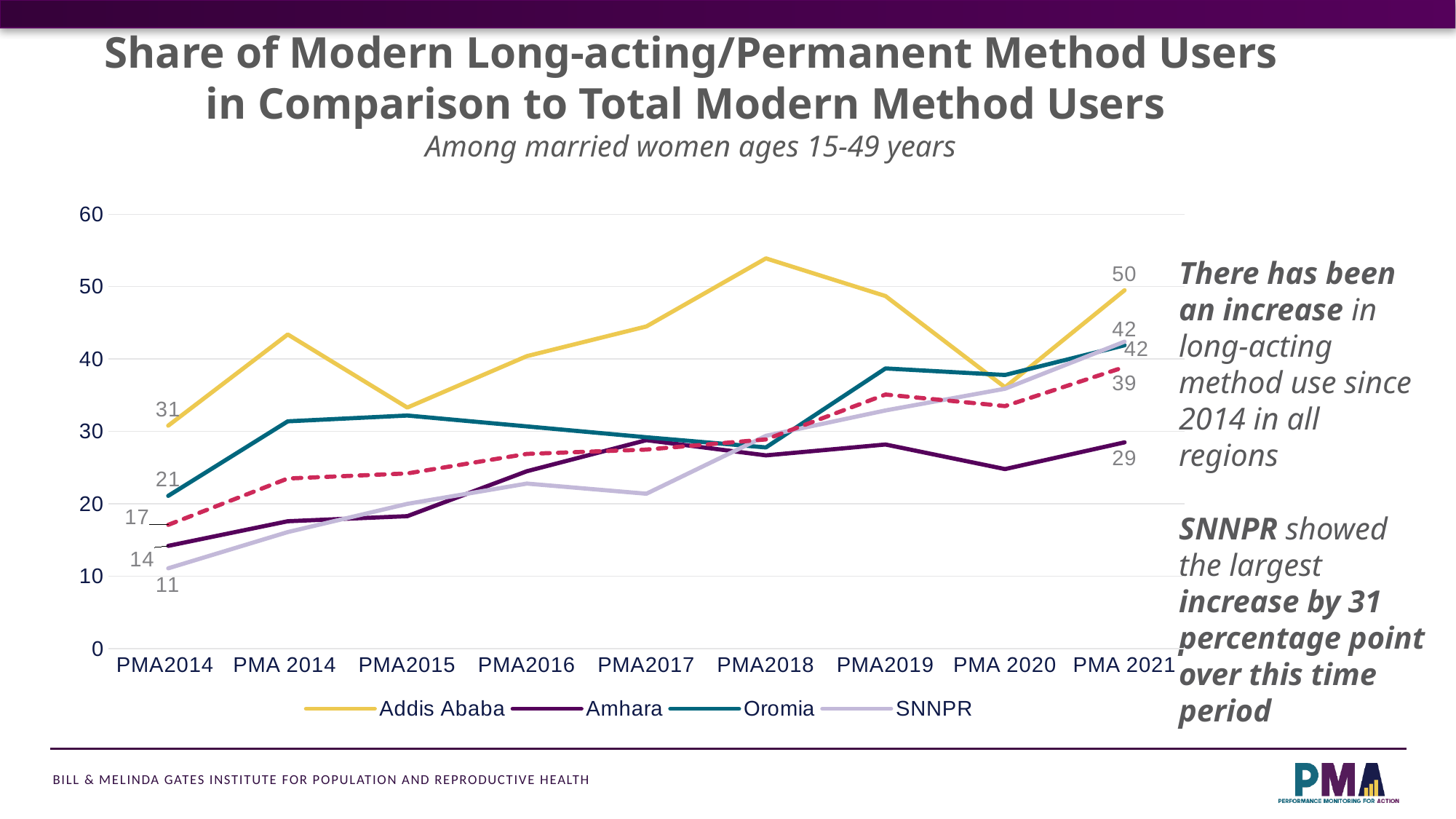
What is the value for SNNPR at PMA2014? 11 What kind of chart is shown on the slide? Line chart Which region has the highest value at PMA 2021? Addis Ababa How many survey rounds are shown along the x axis? 9 Is the value for Addis Ababa at PMA2018 greater or less than 50? greater How many series does the chart legend list? 4 What is the value for Addis Ababa at PMA2014? 31 What is the value for Amhara at PMA 2021? 29 What is the value for Addis Ababa at PMA 2021? 50 At PMA2014, which is larger: the value for Oromia or the value for Amhara? Oromia Which region has the lowest value at PMA2014? SNNPR By how much did the SNNPR value increase from PMA2014 to PMA 2021? 31